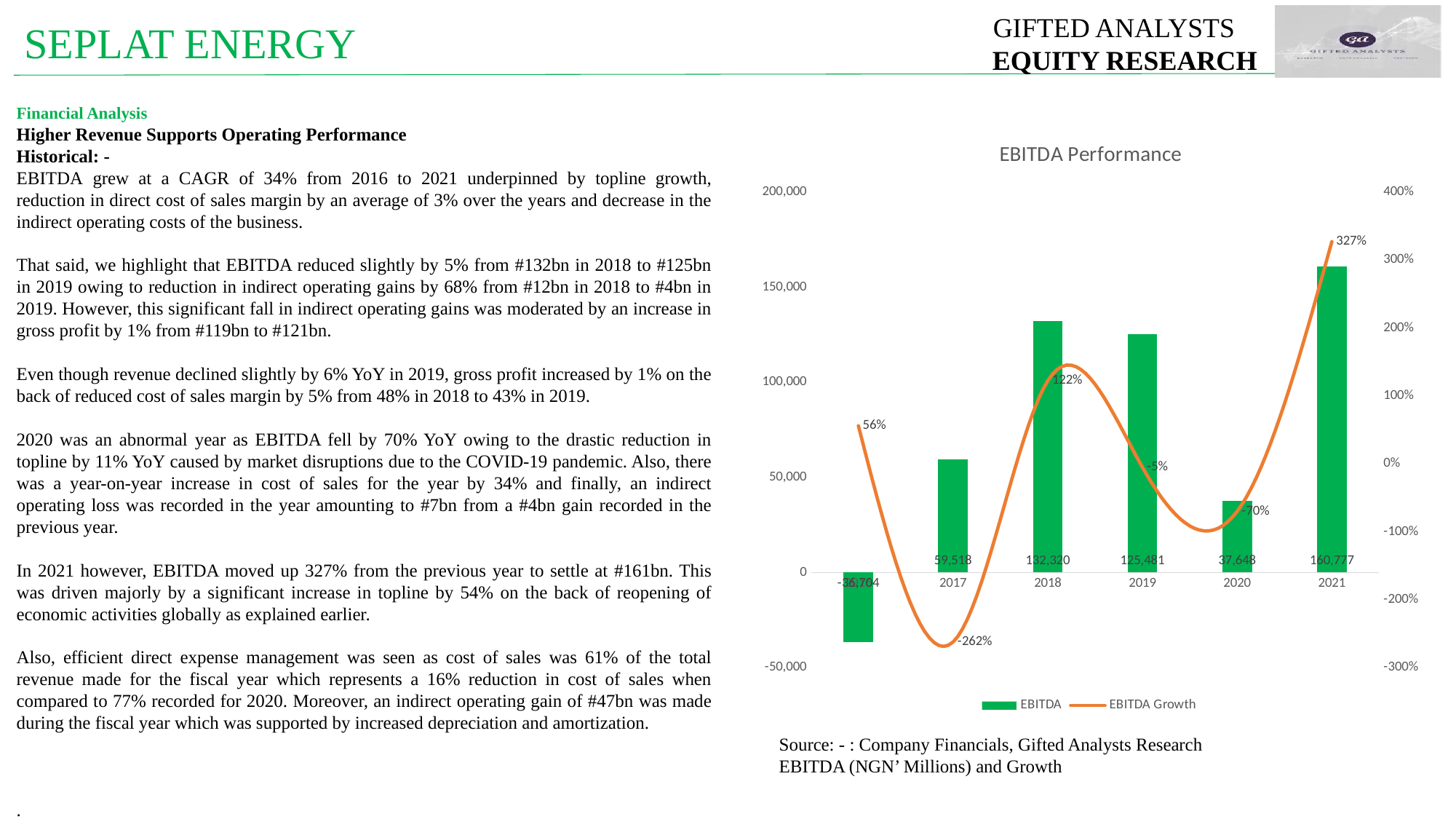
How many years are shown on the x axis of the EBITDA Performance chart? 6 What is the EBITDA value for 2018 in the EBITDA Performance chart? 132,320 Which year has the lowest EBITDA in the EBITDA Performance chart? 2016 How many series does the legend of the EBITDA Performance chart list? 2 What is the EBITDA value for 2021 in the EBITDA Performance chart? 160,777 What is the title of the chart on the slide? EBITDA Performance Which year has the larger EBITDA in the EBITDA Performance chart, 2017 or 2020? 2017 What kind of chart is the EBITDA Performance chart? Combined bar and line chart What is the difference between the EBITDA values for 2018 and 2019 in the EBITDA Performance chart? 6,839 Which year has the highest EBITDA in the EBITDA Performance chart? 2021 What EBITDA growth rate is shown for 2021 in the EBITDA Performance chart? 327% What EBITDA growth rate is shown for 2017 in the EBITDA Performance chart? -262%